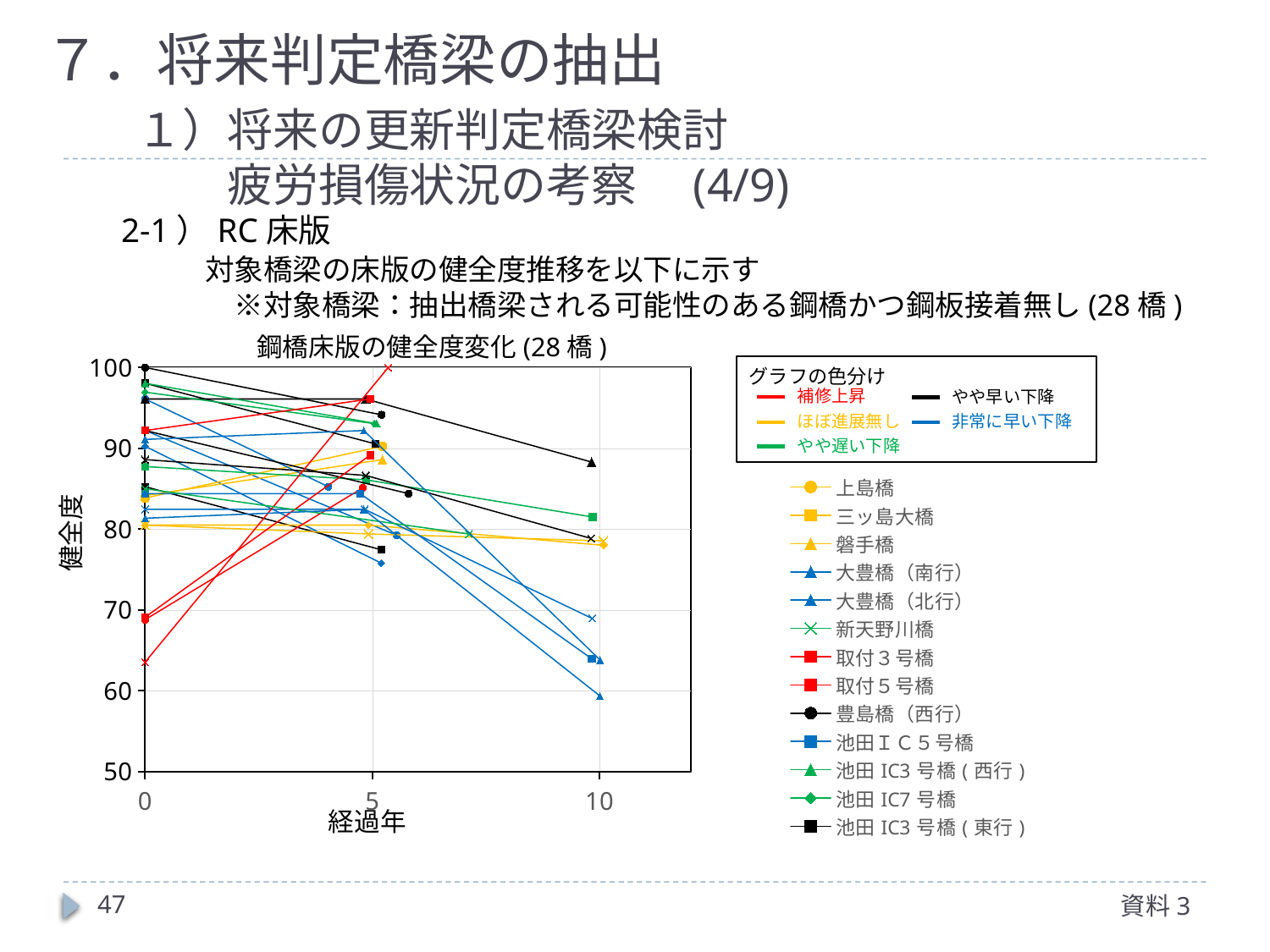
Is the lowest value plotted at year 10 greater or less than 70? less According to the colour key, what do the blue lines represent? 非常に早い下降 What kind of chart is shown on the slide? line chart According to the colour key, what do the red lines represent? 補修上昇 What is the label of the y axis of the chart? 健全度 How many categories does the colour key (グラフの色分け) list? 5 How many series does the chart legend list? 13 Is the highest value plotted at year 10 greater or less than 80? greater Do the blue lines rise or fall between year 5 and year 10? fall